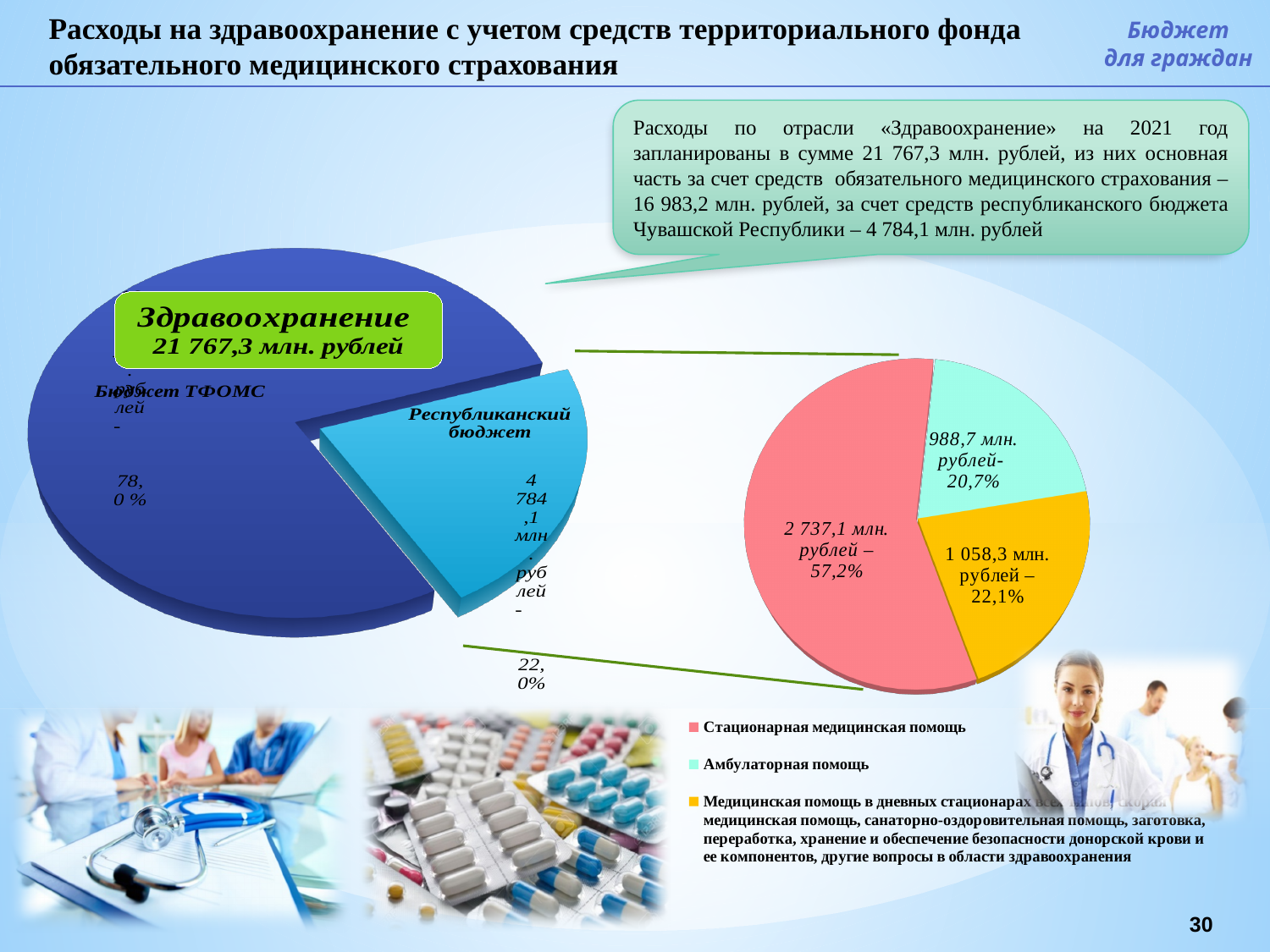
In the right pie chart, what value is shown for Стационарная медицинская помощь? 2 737,1 млн. рублей In the left pie chart, which slice is larger: Бюджет ТФОМС or Республиканский бюджет? Бюджет ТФОМС How many slices does the right pie chart have? 3 What type of chart is the right chart on the slide? pie chart In the right pie chart, which category has the largest share? Стационарная медицинская помощь In the right pie chart, what share is shown for Амбулаторная помощь? 20,7% What type of chart is the left chart on the slide? pie chart In the right pie chart, what value is shown for the yellow slice (Медицинская помощь в дневных стационарах...)? 1 058,3 млн. рублей In the right pie chart, which category has the smallest share? Амбулаторная помощь In the left pie chart, what share is shown for Республиканский бюджет? 22,0% In the left pie chart, what value in млн. рублей is shown for Республиканский бюджет? 4 784,1 млн. рублей In the left pie chart, what share is shown for Бюджет ТФОМС? 78,0 %